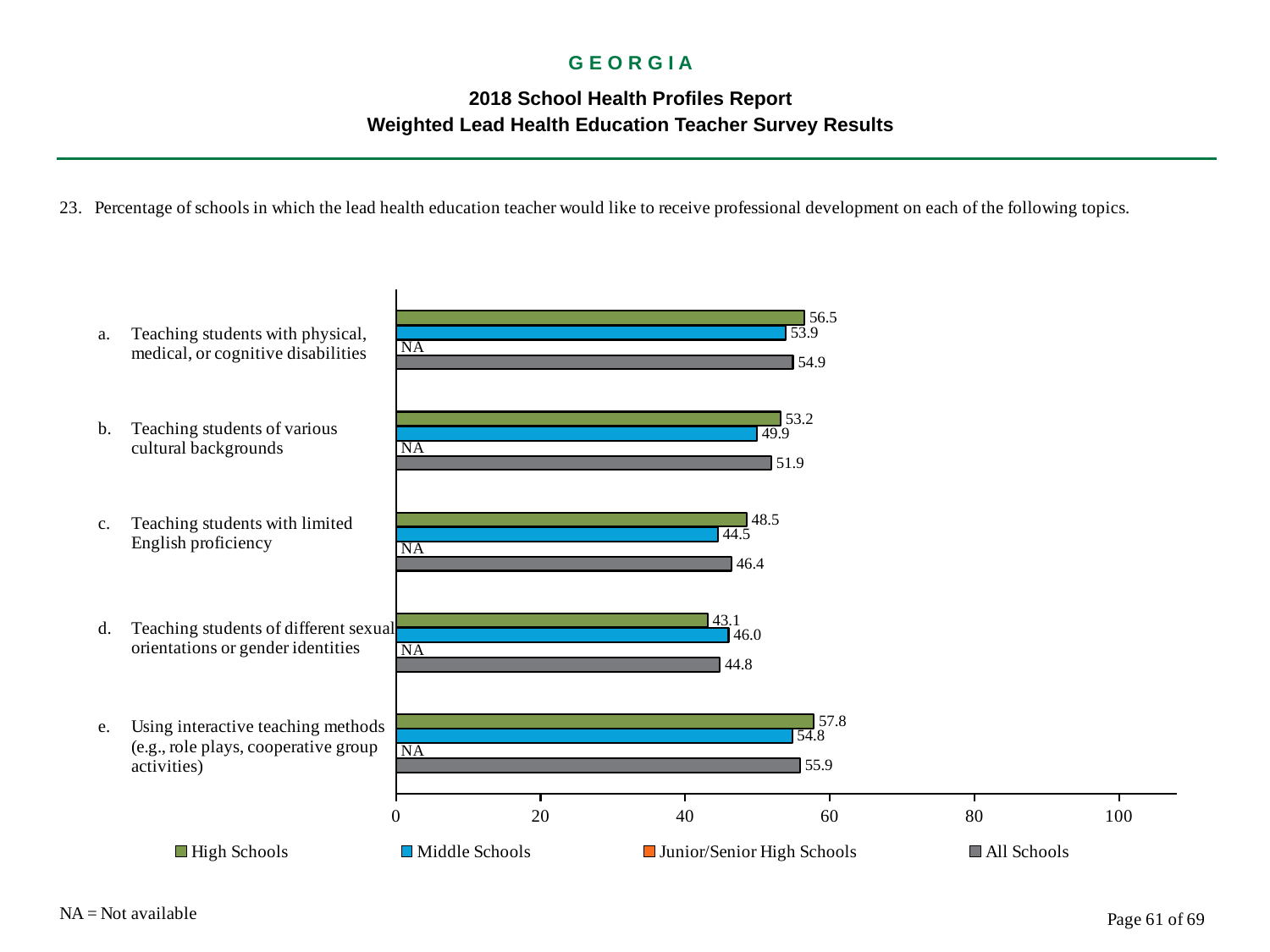
What is the Middle Schools value for teaching students of various cultural backgrounds? 49.9 For teaching students of different sexual orientations or gender identities, which is larger: the High Schools value or the Middle Schools value? Middle Schools What is the High Schools value for teaching students with physical, medical, or cognitive disabilities? 56.5 Is the All Schools value for using interactive teaching methods greater or less than 40? greater What kind of chart is shown on the slide? bar chart What is the difference between the High Schools and Middle Schools values for teaching students with limited English proficiency? 4.0 What is the Middle Schools value for using interactive teaching methods? 54.8 Which topic has the highest High Schools value? Using interactive teaching methods (e.g., role plays, cooperative group activities) How many series does the legend list? 4 Which topic has the lowest All Schools value? Teaching students of different sexual orientations or gender identities What is the All Schools value for teaching students with limited English proficiency? 46.4 How many topics are listed on the chart? 5